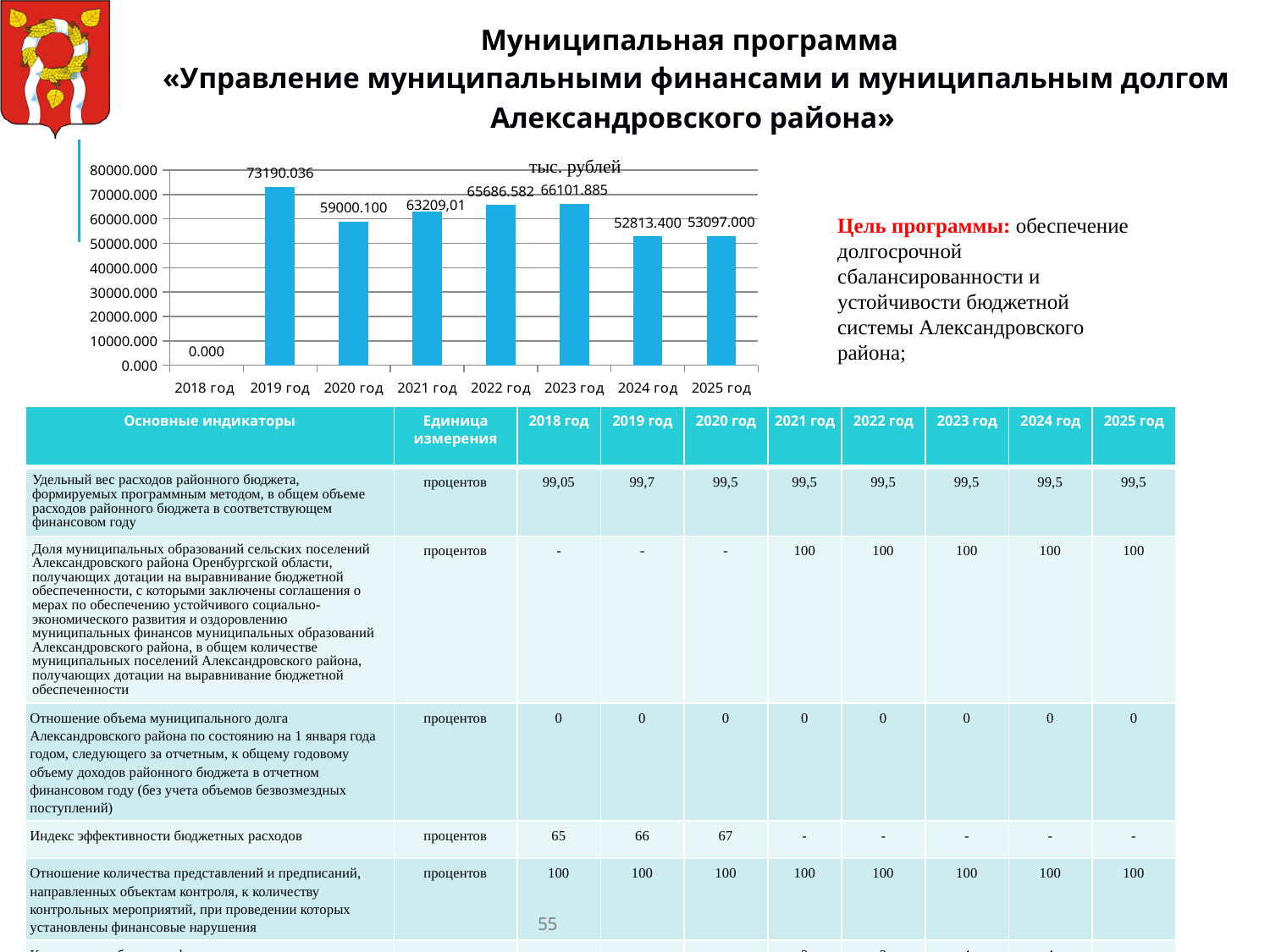
What is the difference between the values for 2023 год and 2022 год? 415.303 Which is larger, the value for 2020 год or the value for 2021 год? 2021 год How many years are shown on the x axis of the chart? 8 What is the value for 2019 год in the chart? 73190.036 What is the value for 2022 год in the chart? 65686.582 Which year has the lowest value in the chart? 2018 год Is the value for 2025 год greater or less than 60000.000? less What is the value for 2018 год in the chart? 0.000 What type of chart is shown on the slide? bar chart What is the value for 2024 год in the chart? 52813.400 Which year has the highest value in the chart? 2019 год What is the title of the chart? тыс. рублей